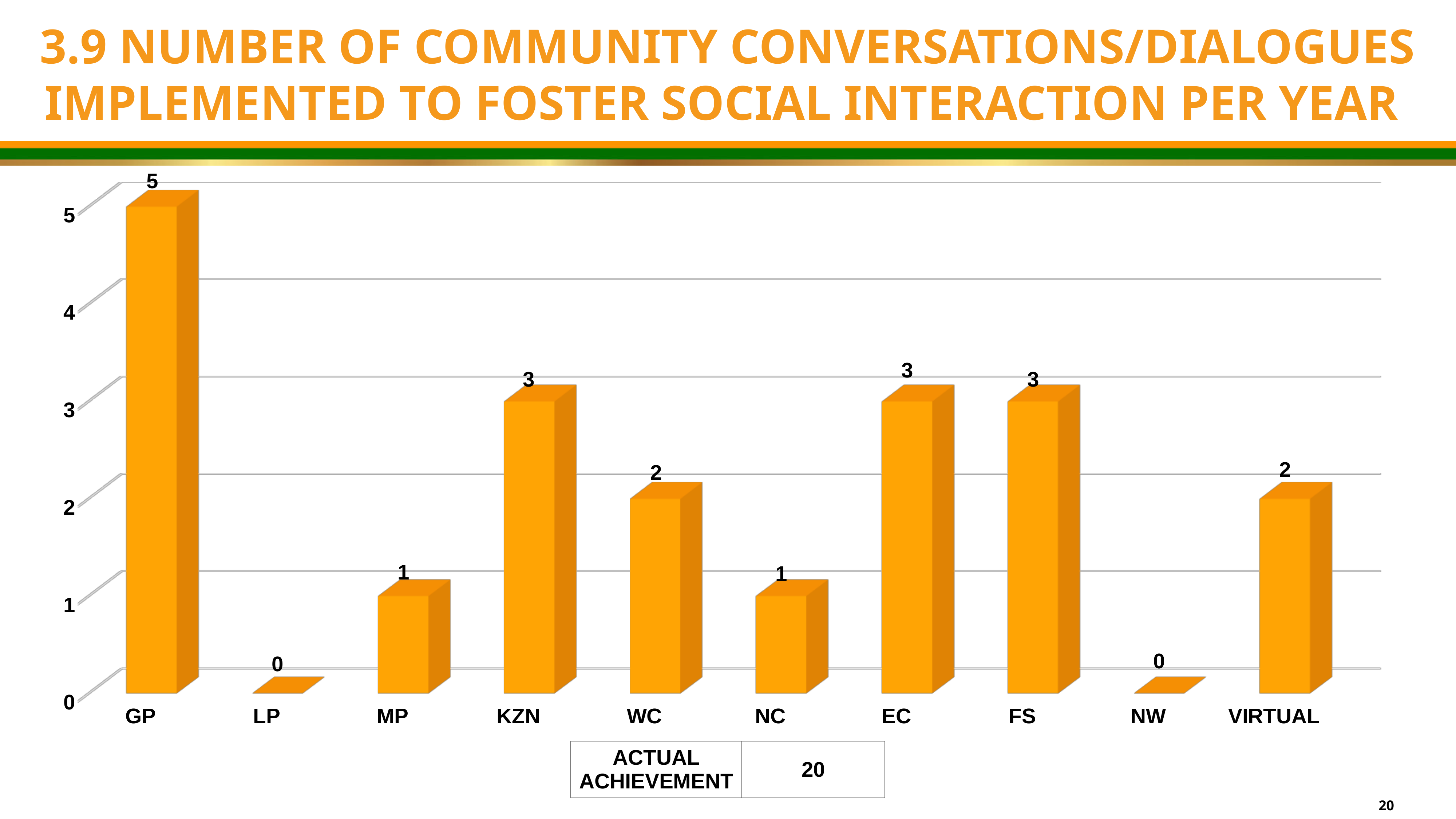
What is the difference between the values for GP and WC? 3 What is the value for NC? 1 What is the total of all the bar values shown in the chart? 20 How many categories are shown on the x axis? 10 What value is shown in the ACTUAL ACHIEVEMENT box below the chart? 20 What is the value for GP? 5 What is the value for VIRTUAL? 2 Which is larger, the value for MP or the value for EC? EC What is the value for KZN? 3 Which categories have a value of 0? LP and NW What kind of chart is shown on the slide? Bar chart Which category has the highest value? GP